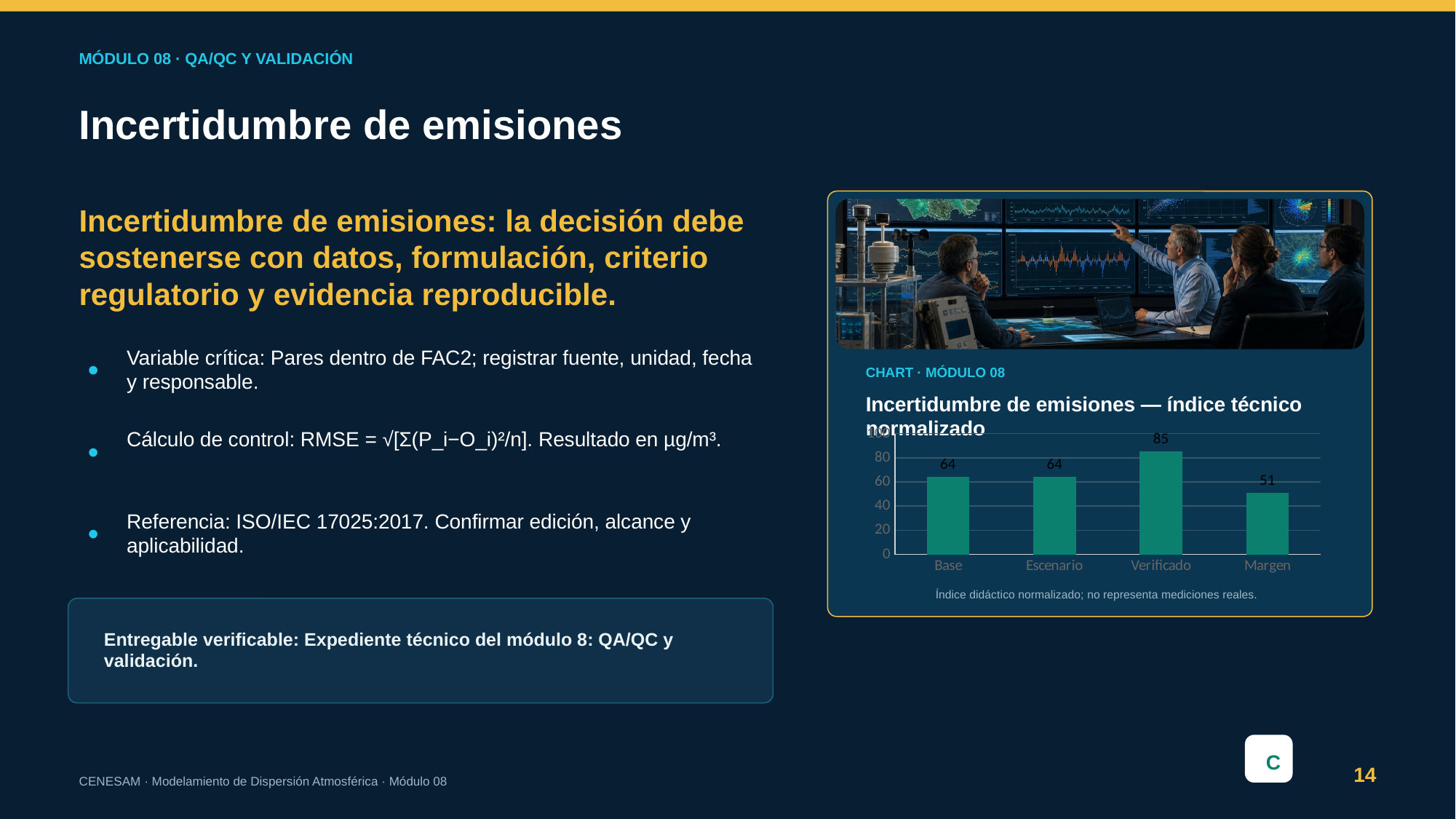
What is the value for Margen? 51 How many categories are shown on the x axis? 4 Which category has the lowest value? Margen What is the difference between the values for Verificado and Escenario? 21 What is the title of the chart? Incertidumbre de emisiones — índice técnico normalizado What is the value for Verificado? 85 What is the difference between the values for Verificado and Margen? 34 What is the value for Base? 64 Is the value for Verificado greater or less than 80? greater What kind of chart is shown? bar chart Which category has the highest value? Verificado Which is larger, the value for Escenario or the value for Margen? Escenario